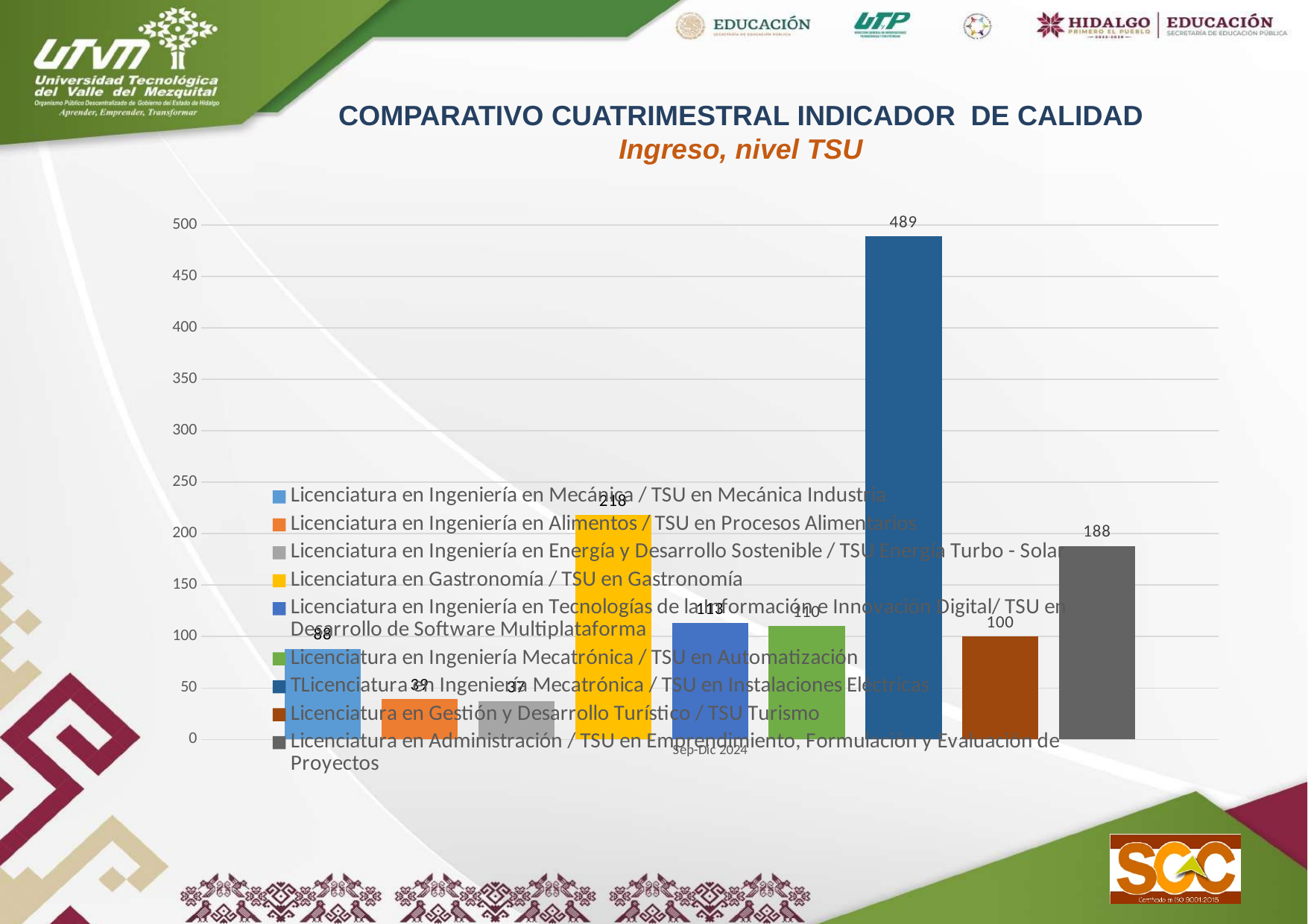
What is the value for Licenciatura en Gastronomía / TSU en Gastronomía? 218 Which is larger, the value for TSU en Gastronomía or the value for TSU en Emprendimiento, Formulación y Evaluación de Proyectos? TSU en Gastronomía What is the value for Licenciatura en Ingeniería Mecatrónica / TSU en Instalaciones Eléctricas? 489 What period is labelled on the x axis of the chart? Sep-Dic 2024 How many series does the legend list? 9 What is the value for Licenciatura en Ingeniería en Mecánica / TSU en Mecánica Industrial? 88 Which series has the highest value? Licenciatura en Ingeniería Mecatrónica / TSU en Instalaciones Eléctricas What is the value for Licenciatura en Administración / TSU en Emprendimiento, Formulación y Evaluación de Proyectos? 188 What kind of chart is shown on the slide? bar chart Is the value for Licenciatura en Ingeniería en Energía y Desarrollo Sostenible / TSU Energía Turbo - Solar greater or less than 50? less What is the difference between the values for TSU en Instalaciones Eléctricas and TSU en Gastronomía? 271 What is the value for Licenciatura en Gestión y Desarrollo Turístico / TSU Turismo? 100